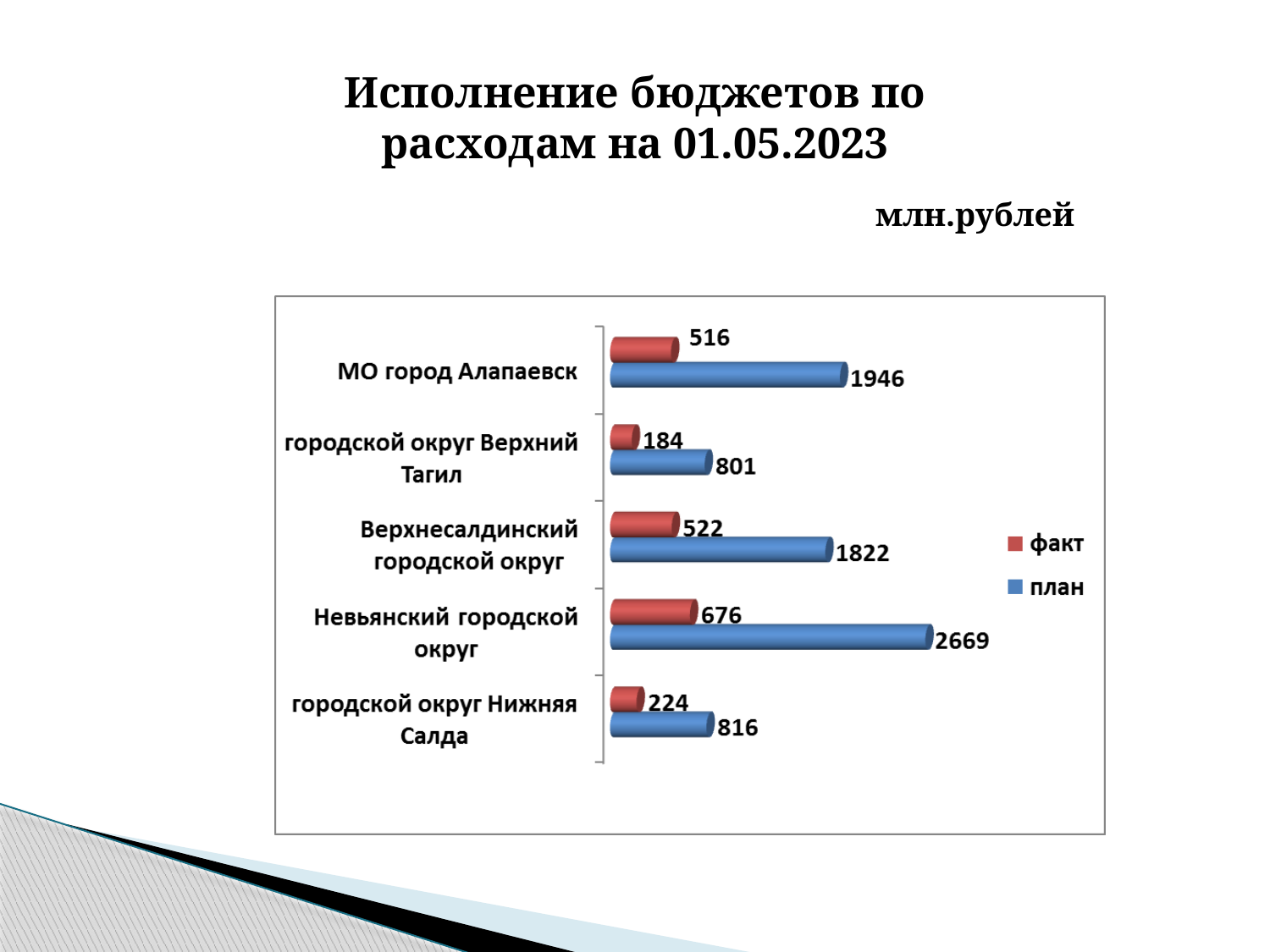
What is the difference between the план and факт values for Верхнесалдинский городской округ? 1300 What is the факт value for городской округ Нижняя Салда? 224 Which colour represents the факт series in the legend? red What kind of chart is shown on the slide? bar chart What is the план value for МО город Алапаевск? 1946 Which category has the highest план value? Невьянский городской округ What is the факт value for городской округ Верхний Тагил? 184 Which category has the lowest факт value? городской округ Верхний Тагил How many series does the legend list? 2 How many categories are shown on the chart? 5 Which is larger: the план value for городской округ Нижняя Салда or the план value for городской округ Верхний Тагил? городской округ Нижняя Салда What is the план value for Невьянский городской округ? 2669